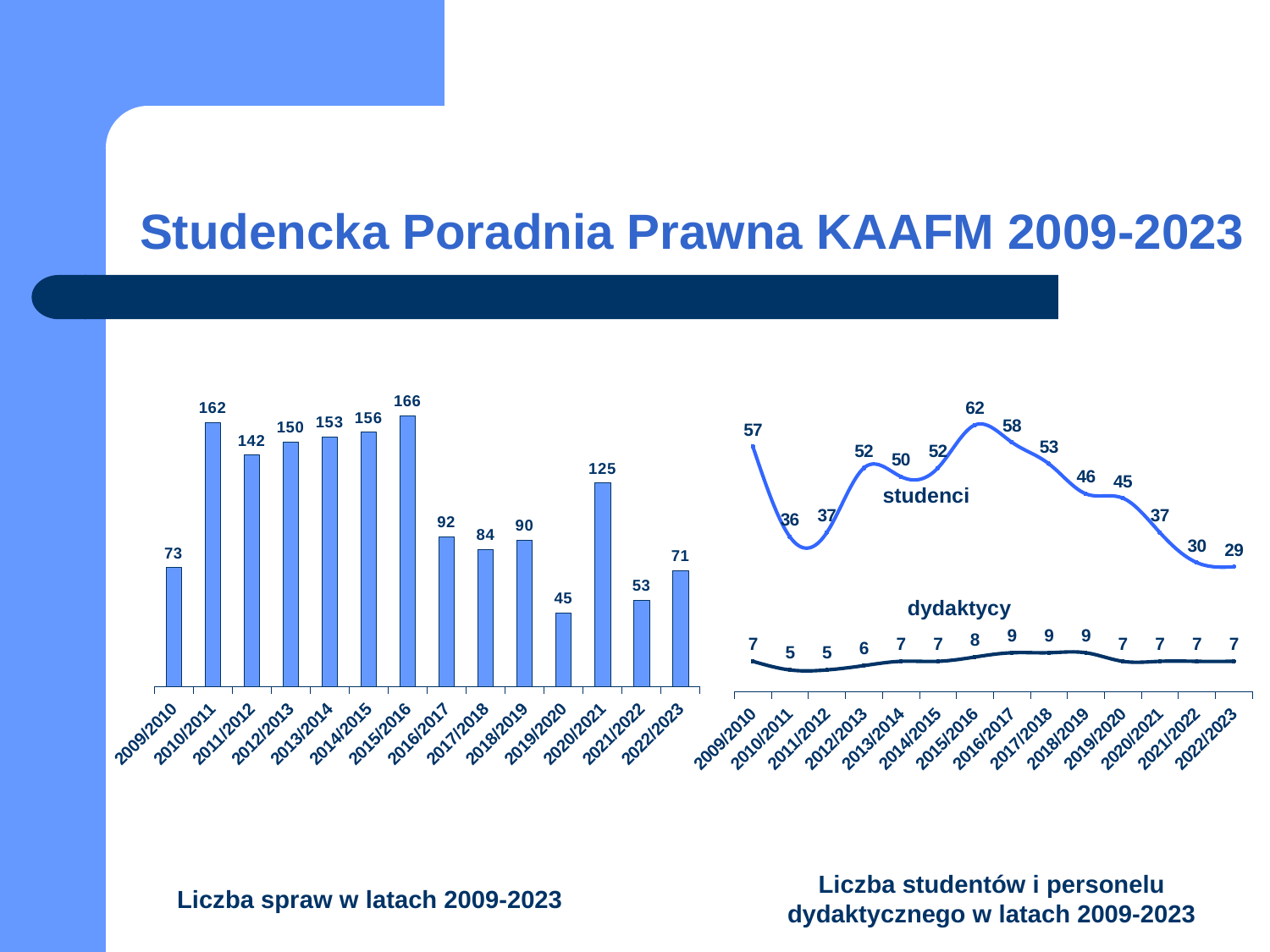
What kind of chart is 'Liczba studentów i personelu dydaktycznego w latach 2009-2023'? line chart In the chart 'Liczba spraw w latach 2009-2023', how many years are shown on the x axis? 14 In the chart 'Liczba spraw w latach 2009-2023', what is the value for 2015/2016? 166 In the chart 'Liczba spraw w latach 2009-2023', which year has the lowest value? 2019/2020 In the chart 'Liczba studentów i personelu dydaktycznego w latach 2009-2023', which year has the lowest value in the studenci series? 2022/2023 In the chart 'Liczba studentów i personelu dydaktycznego w latach 2009-2023', does the studenci series rise or fall from 2015/2016 to 2022/2023? fall What kind of chart is 'Liczba spraw w latach 2009-2023'? bar chart In the chart 'Liczba studentów i personelu dydaktycznego w latach 2009-2023', what is the value of the studenci series for 2015/2016? 62 In the chart 'Liczba spraw w latach 2009-2023', which year has the highest value? 2015/2016 In the chart 'Liczba spraw w latach 2009-2023', what is the difference between the values for 2010/2011 and 2009/2010? 89 In the chart 'Liczba spraw w latach 2009-2023', which is larger, the value for 2020/2021 or the value for 2016/2017? 2020/2021 In the chart 'Liczba studentów i personelu dydaktycznego w latach 2009-2023', what is the value of the dydaktycy series for 2017/2018? 9